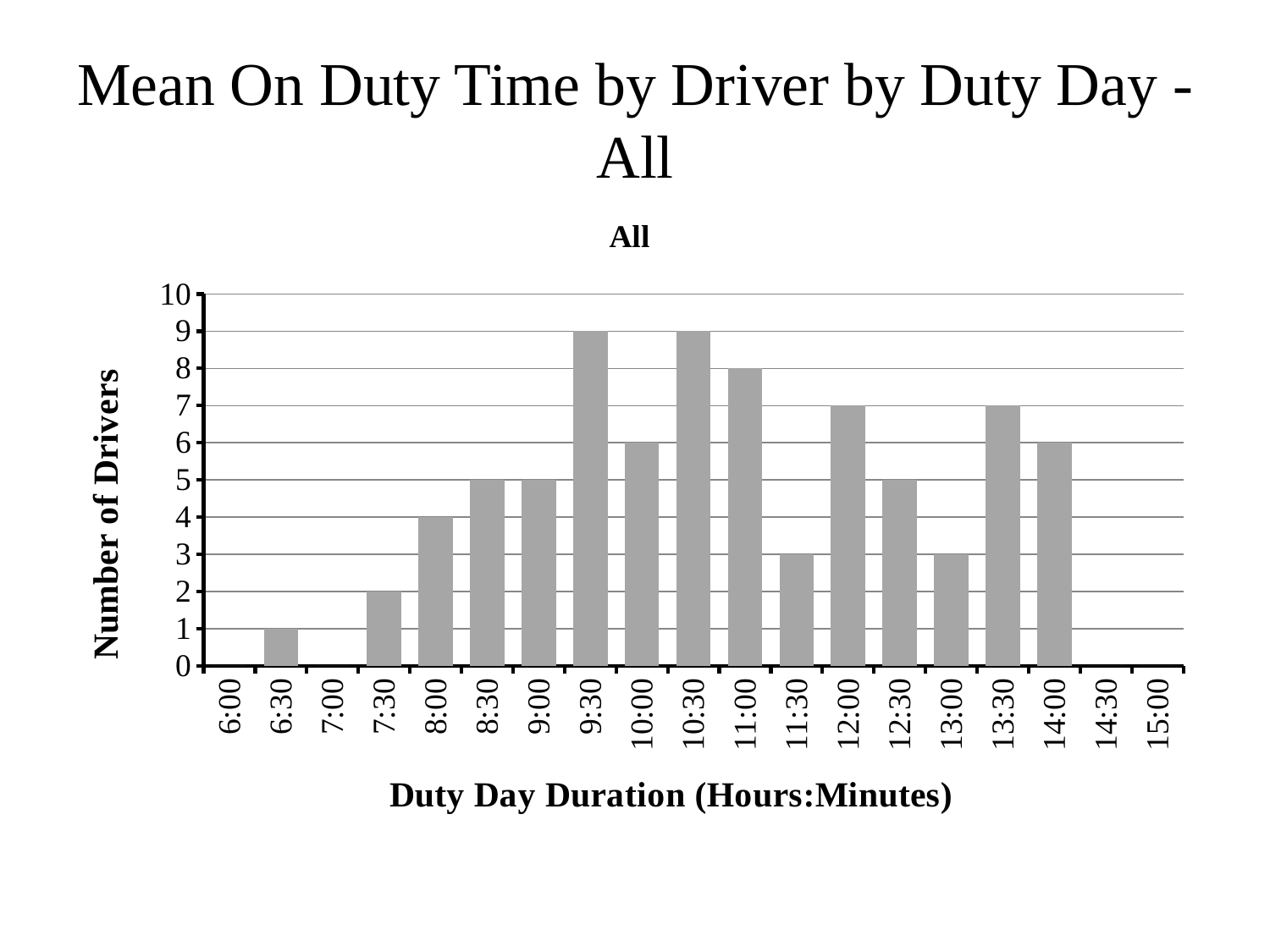
Which has more drivers, the 10:00 or the 13:00 duty day duration? 10:00 Which has more drivers, the 7:30 or the 14:00 duty day duration? 14:00 How many drivers are shown for the 11:00 duty day duration? 8 What type of chart is shown on the slide? bar chart What is the highest number of drivers shown for any duty day duration? 9 What is the label of the x axis? Duty Day Duration (Hours:Minutes) What is the label of the y axis? Number of Drivers What is the difference in number of drivers between the 10:30 and 11:30 duty day durations? 6 How many drivers are shown for the 6:30 duty day duration? 1 How many duty day duration categories are shown on the x axis? 19 How many drivers are shown for the 12:00 duty day duration? 7 How many drivers are shown for the 8:00 duty day duration? 4